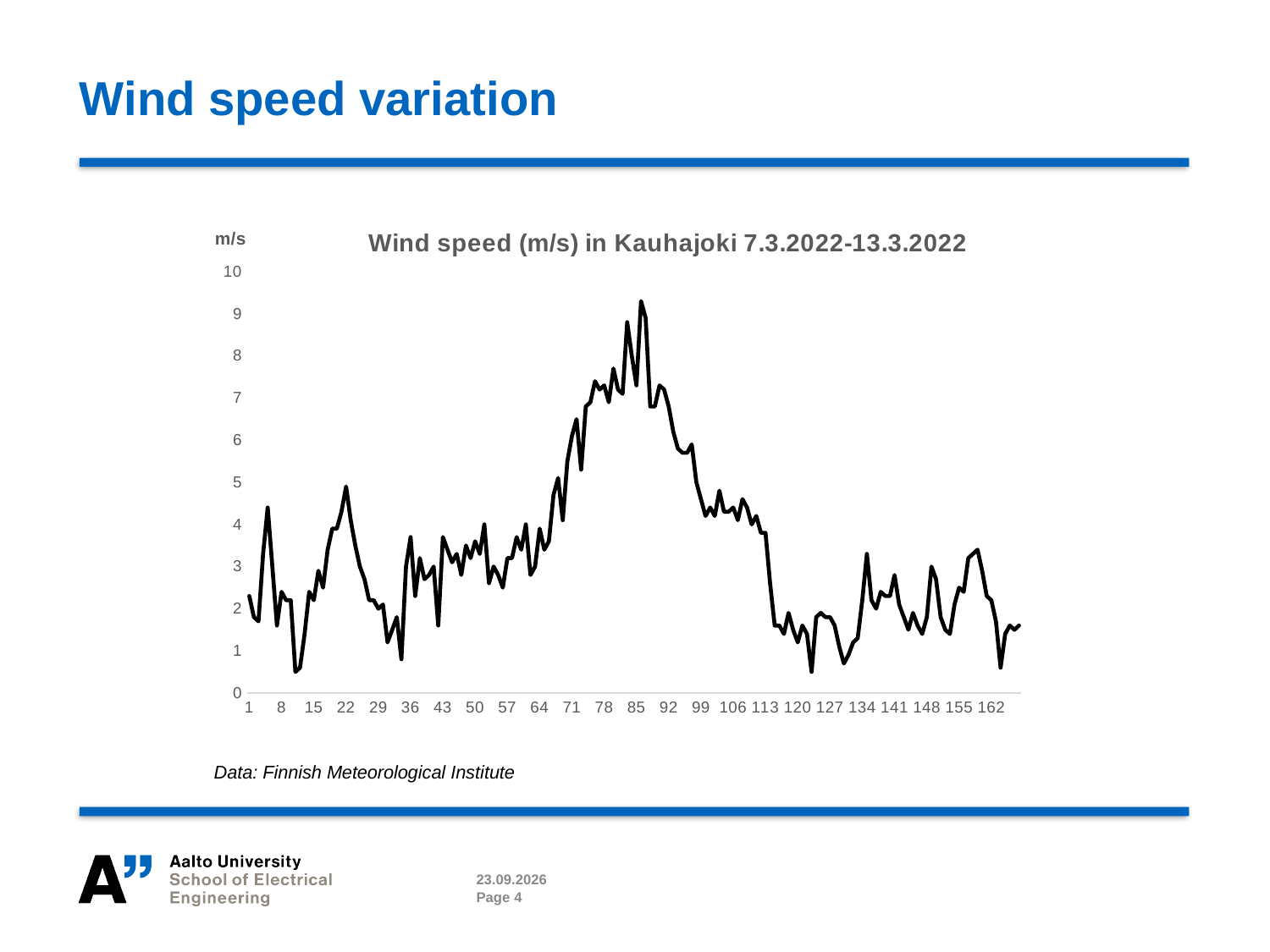
What unit label is shown at the top of the vertical axis? m/s Is the wind speed value at point 78 greater or less than 6 m/s? greater How many data series (lines) are plotted on the chart? 1 What is the title of the chart? Wind speed (m/s) in Kauhajoki 7.3.2022-13.3.2022 Does the wind speed generally rise or fall between point 57 and point 85? rise Is the wind speed value at point 162 greater or less than 3 m/s? less What kind of chart is shown on the slide? line chart Which is larger, the wind speed at point 85 or the wind speed at point 127? point 85 Is the wind speed value at point 120 greater or less than 3 m/s? less Does the wind speed generally rise or fall between point 92 and point 120? fall